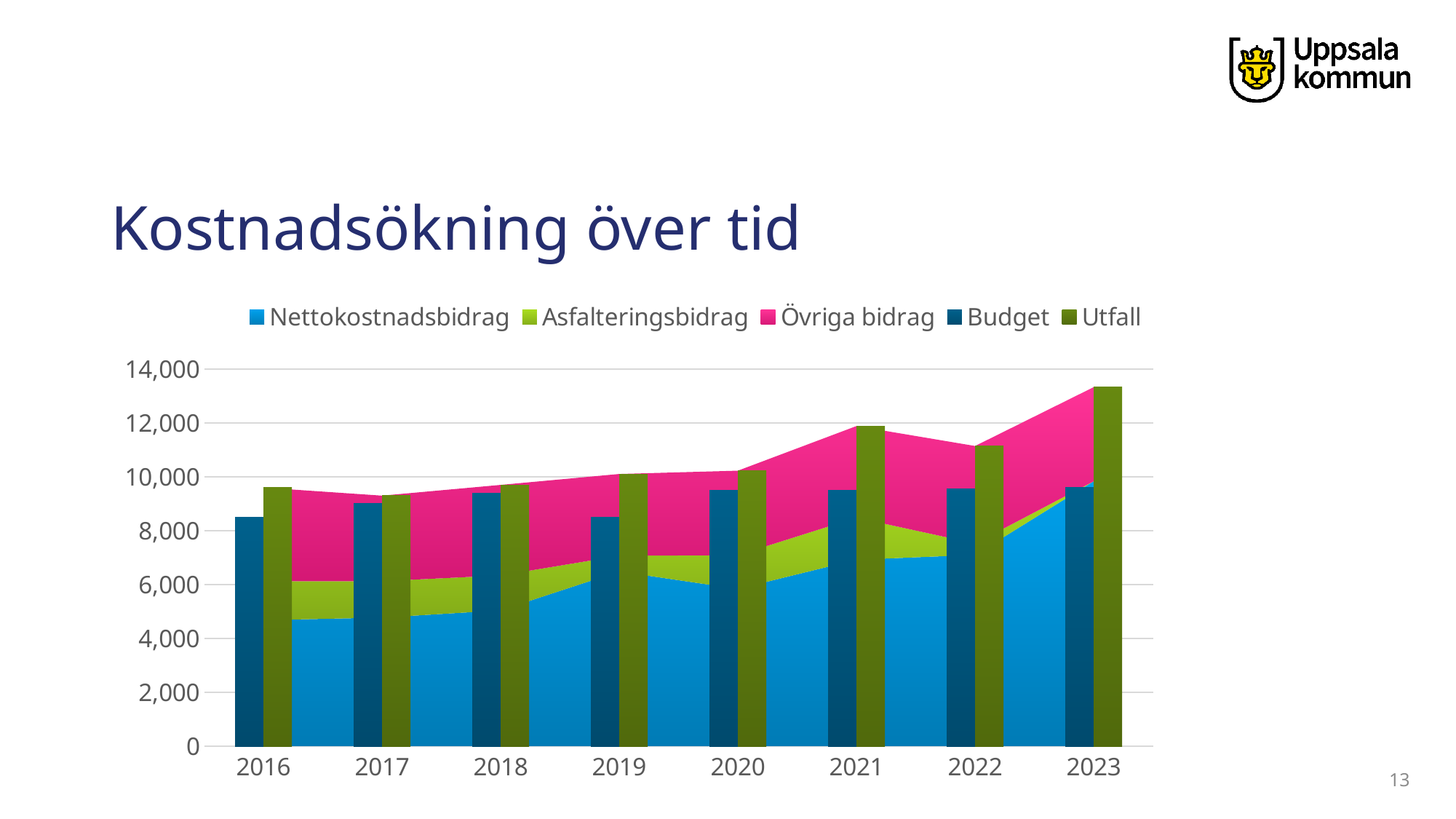
What kind of chart is this? A combination of a stacked area chart and a bar chart In which year is the Utfall bar highest? 2023 In 2023, which is larger, Budget or Utfall? Utfall Is the Utfall value for 2023 greater or less than 12,000? greater In 2021, which is larger, Budget or Utfall? Utfall What is the title of the chart? Kostnadsökning över tid Does the Utfall series generally rise or fall from 2016 to 2023? rise How many years are shown on the x axis? 8 Is the Utfall value for 2022 greater or less than 10,000? greater How many series does the legend list? 5 Is the Budget value for 2019 greater or less than 10,000? less